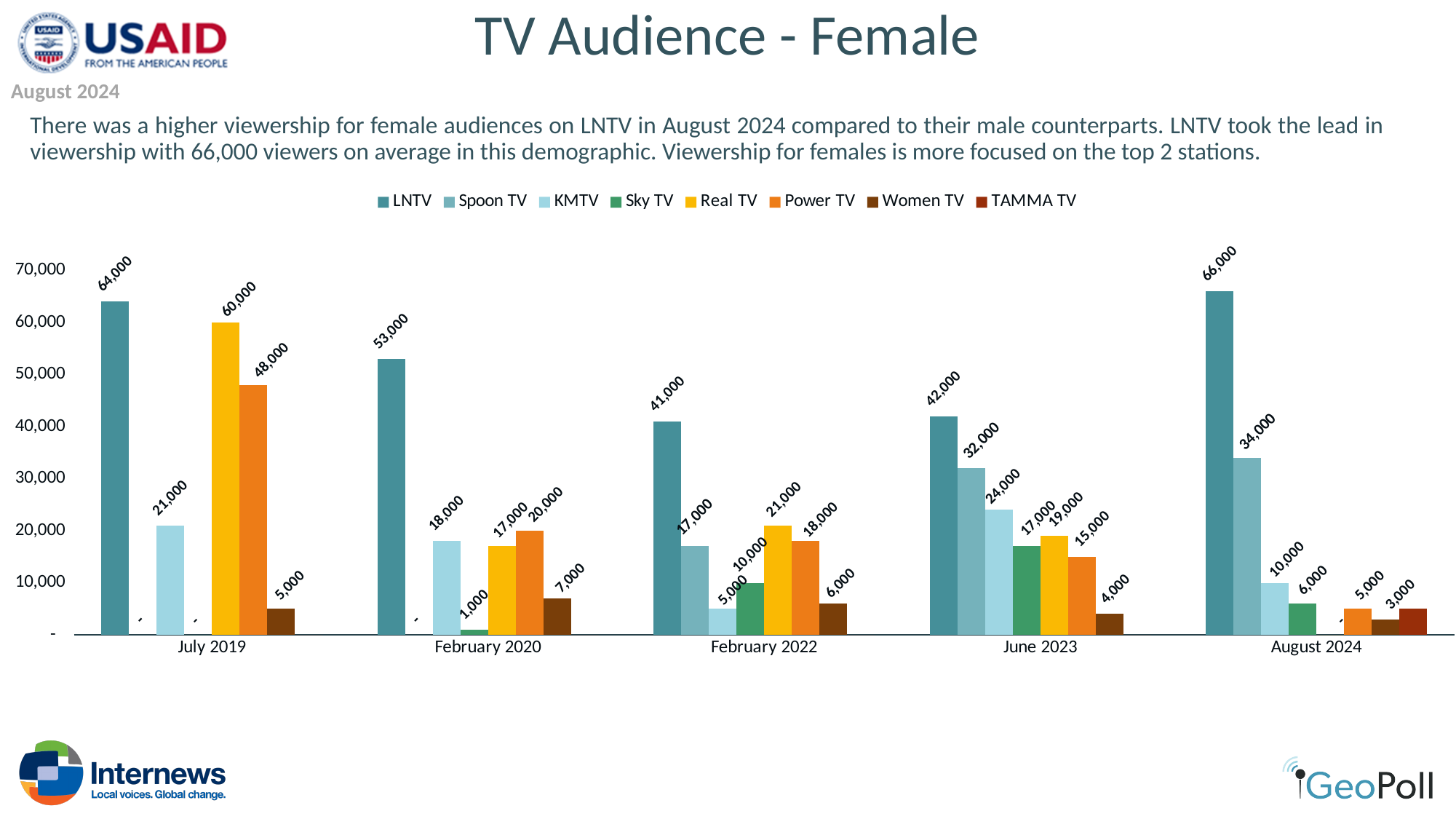
What is the Real TV value for July 2019? 60,000 How many time periods are shown on the x axis? 5 What is the LNTV value for August 2024? 66,000 In February 2020, which is larger: Real TV or Power TV? Power TV How many series does the legend list? 8 What is the Spoon TV value for June 2023? 32,000 What is the Sky TV value for February 2022? 10,000 What is the difference between the LNTV and Spoon TV values in August 2024? 32,000 In which period is the LNTV value highest? August 2024 What is the KMTV value for June 2023? 24,000 In which period is the LNTV value lowest? February 2022 What kind of chart is shown on the slide? Bar chart